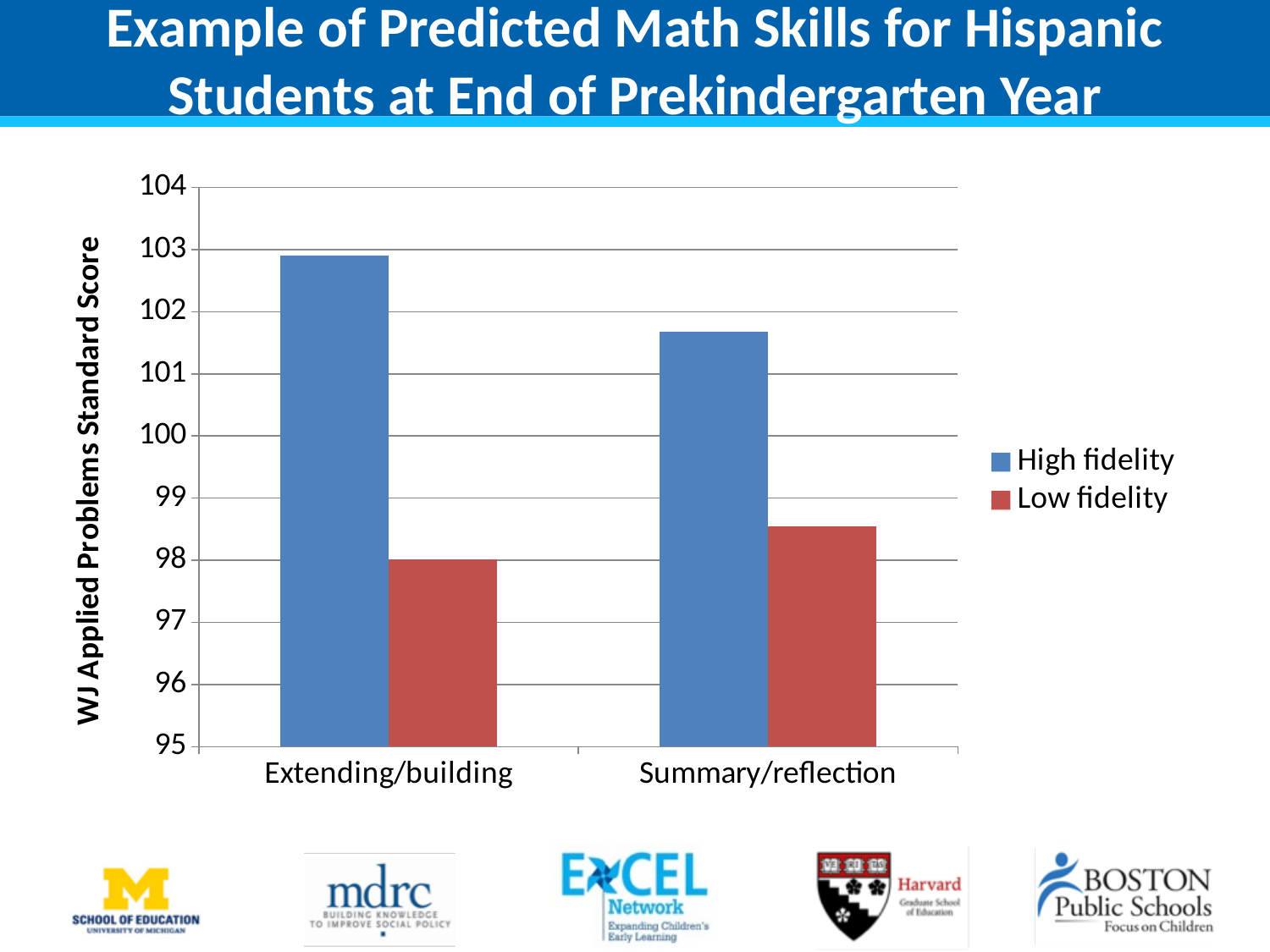
For the High fidelity series, which category has the larger value: Extending/building or Summary/reflection? Extending/building Is the Low fidelity value for Extending/building greater or less than 99? less Is the High fidelity value for Summary/reflection greater or less than 102? less Which series and category has the highest bar? High fidelity, Extending/building Is the Low fidelity value for Summary/reflection greater or less than 98? greater For the Low fidelity series, which category has the larger value: Extending/building or Summary/reflection? Summary/reflection What is the title of the y axis? WJ Applied Problems Standard Score How many series does the legend list? 2 What kind of chart is shown on the slide? bar chart Which series and category has the lowest bar? Low fidelity, Extending/building How many categories are shown on the x axis? 2